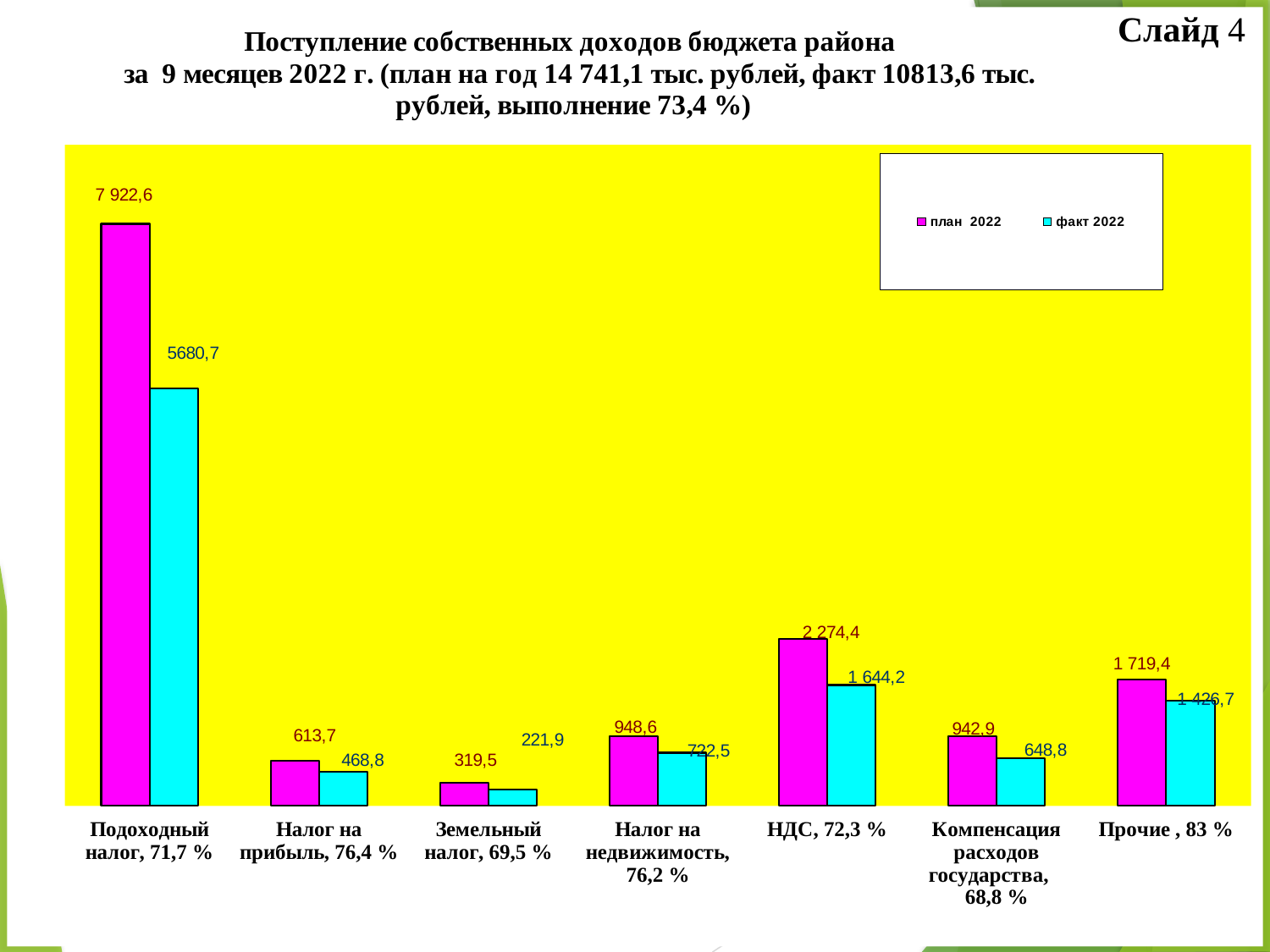
What is the факт 2022 value for Подоходный налог? 5680,7 Which category has the highest план 2022 value? Подоходный налог How many categories are shown on the x axis? 7 What is the план 2022 value for Подоходный налог? 7 922,6 Which is larger: the план 2022 value for Прочие or the план 2022 value for Налог на недвижимость? Прочие What is the факт 2022 value for НДС? 1 644,2 What is the difference between the план 2022 and факт 2022 values for НДС? 630,2 What kind of chart is shown on the slide? Bar chart What is the план 2022 value for Земельный налог? 319,5 What is the difference between the план 2022 and факт 2022 values for Налог на прибыль? 144,9 How many series does the legend list? 2 Which category has the lowest факт 2022 value? Земельный налог